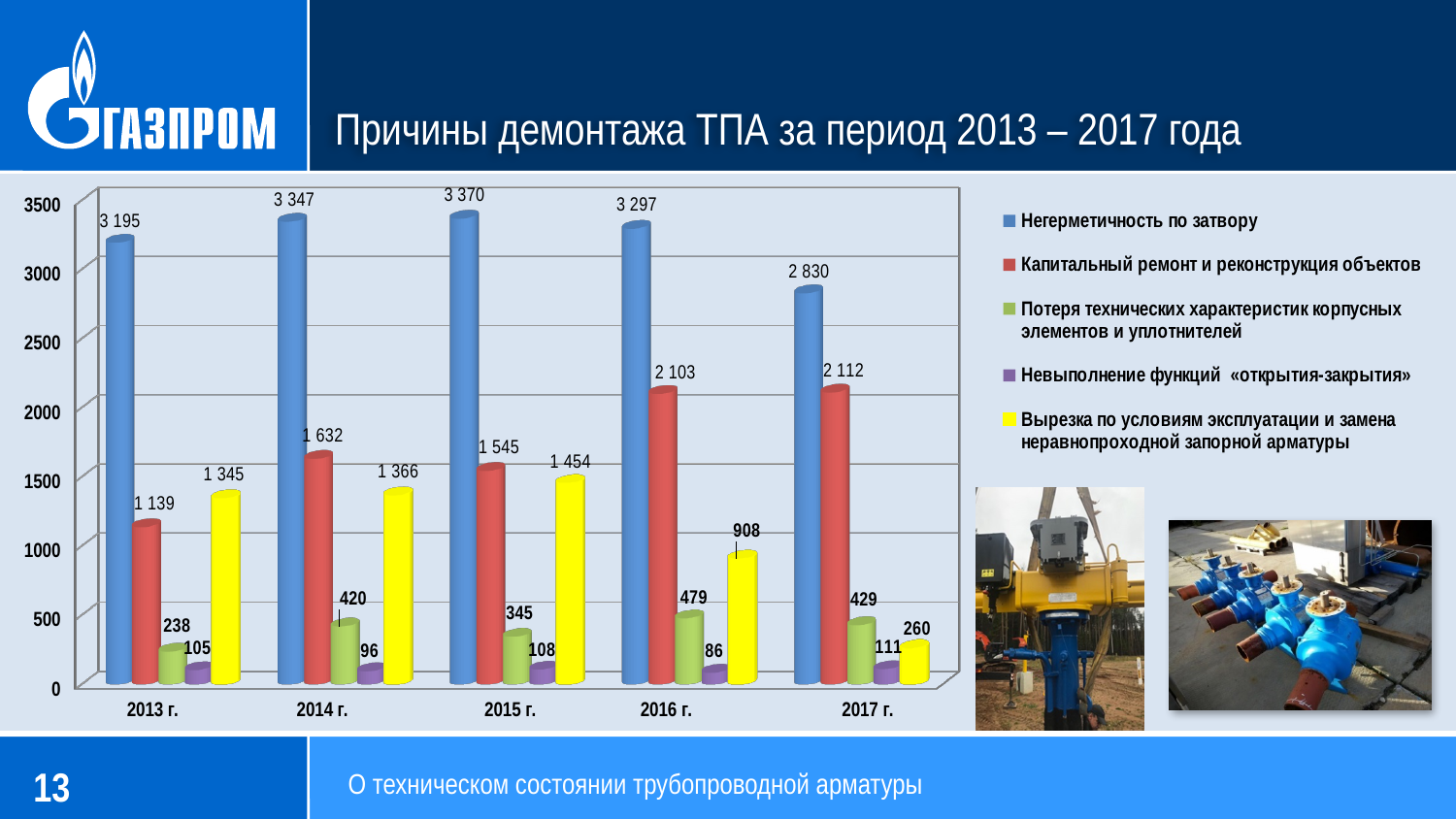
How many years are shown on the x axis of the chart? 5 What is the value for «Невыполнение функций «открытия-закрытия»» in 2014 г.? 96 What is the value for «Негерметичность по затвору» in 2015 г.? 3 370 What is the value for «Вырезка по условиям эксплуатации и замена неравнопроходной запорной арматуры» in 2016 г.? 908 How many series does the legend list? 5 Which is larger: «Потеря технических характеристик корпусных элементов и уплотнителей» in 2016 г. or in 2017 г.? 2016 г. In which year is the value for «Негерметичность по затвору» the lowest? 2017 г. What kind of chart is shown on the slide? Bar chart What is the value for «Капитальный ремонт и реконструкция объектов» in 2017 г.? 2 112 In which year is the value for «Капитальный ремонт и реконструкция объектов» the highest? 2017 г. What is the difference between the «Негерметичность по затвору» values for 2014 г. and 2017 г.? 517 Does the value for «Капитальный ремонт и реконструкция объектов» rise or fall from 2013 г. to 2014 г.? Rise